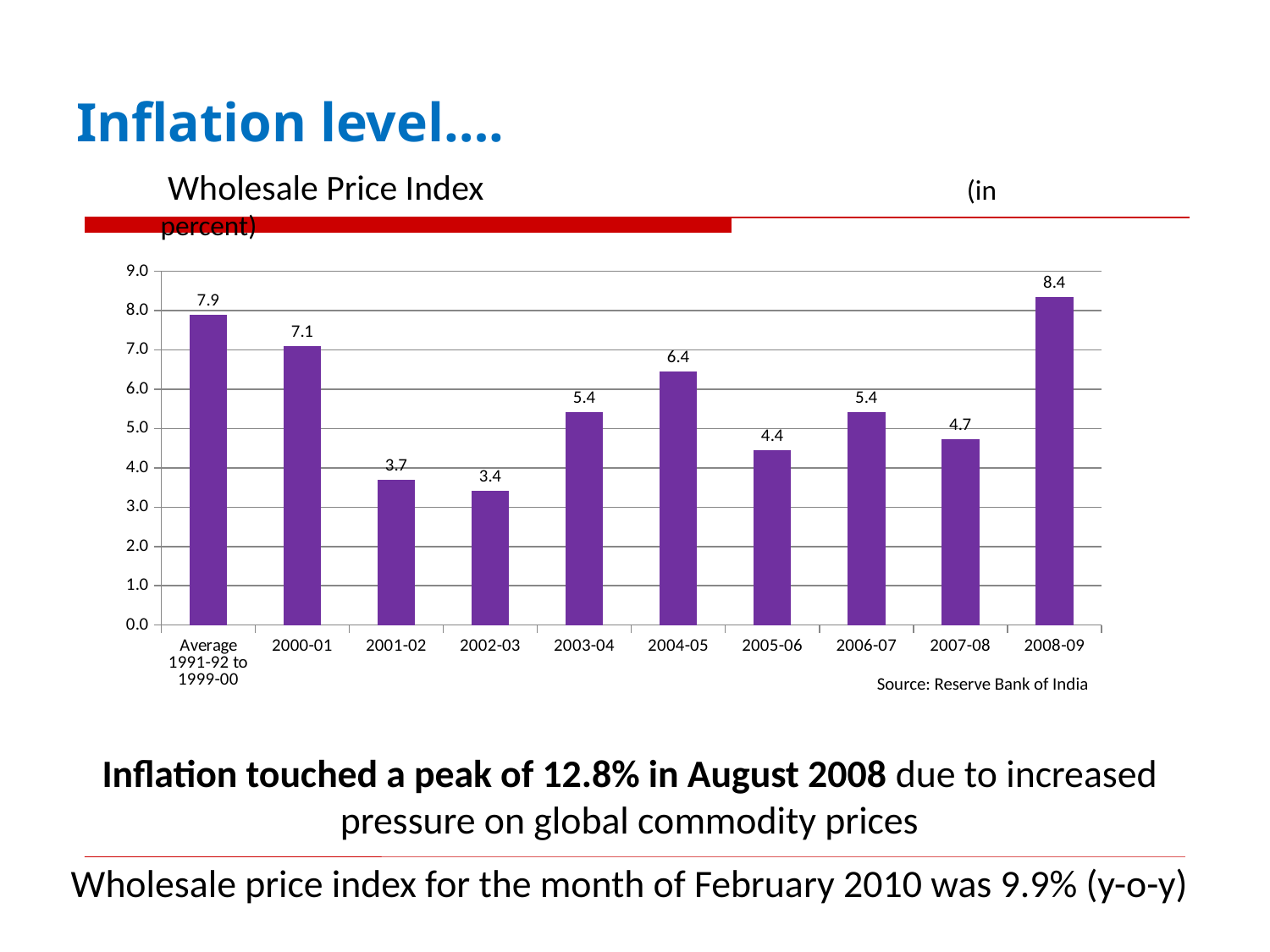
What source is cited for the chart data? Reserve Bank of India Which category has the highest value in the chart? 2008-09 How many categories are shown on the x axis of the chart? 10 Which category has the lowest value in the chart? 2002-03 What kind of chart is shown on the slide? bar chart Is the value for 2000-01 greater or less than 6.0? greater What is the Wholesale Price Index value for 2008-09? 8.4 Do the values rise or fall from 2005-06 to 2006-07? rise What is the value for the Average 1991-92 to 1999-00 category? 7.9 What is the value shown for 2002-03? 3.4 What is the difference between the values for 2008-09 and 2007-08? 3.7 Which is larger, the value for 2004-05 or the value for 2005-06? 2004-05